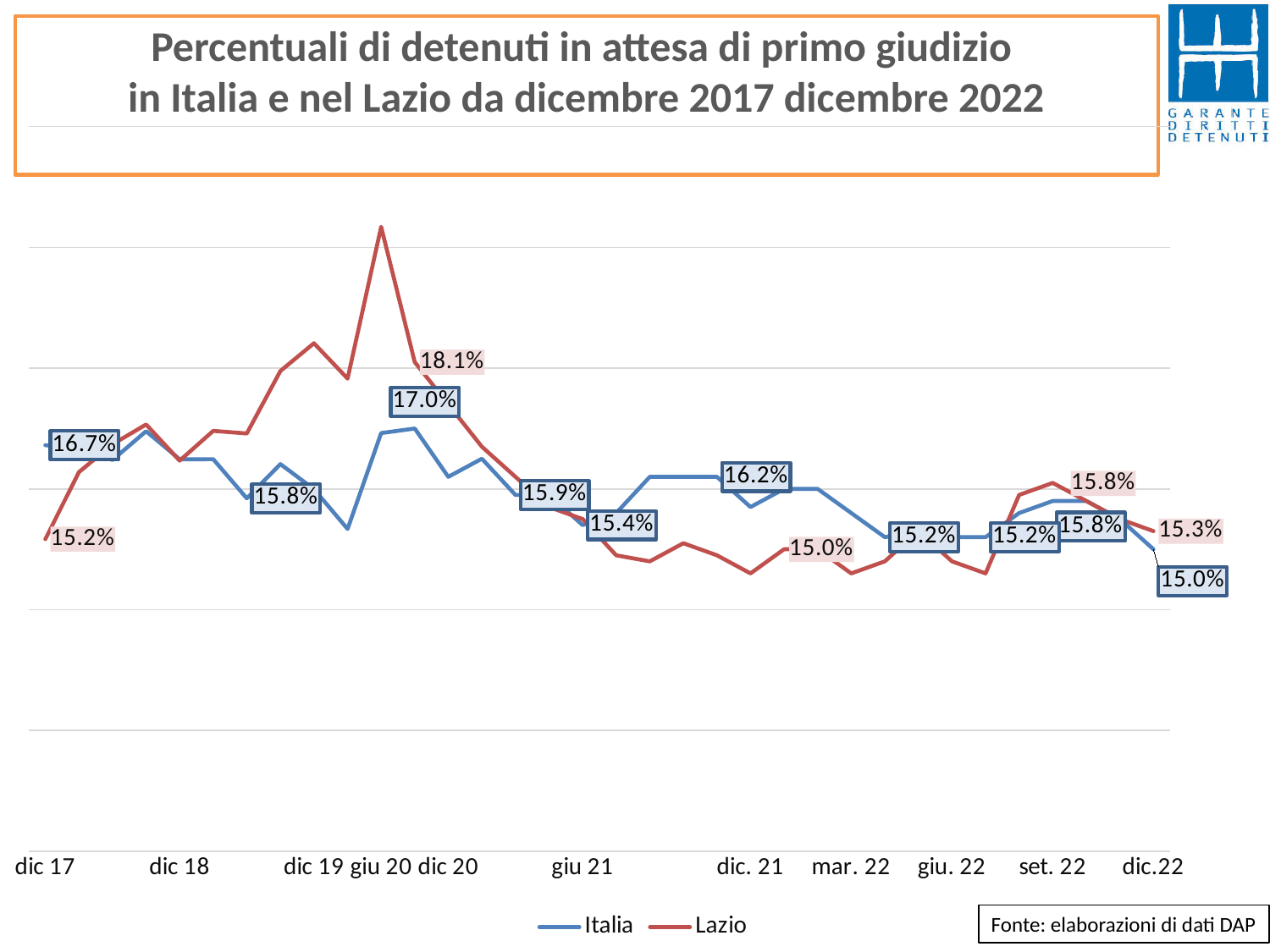
What is the value for Italia at dic.22? 15.0% What kind of chart is shown on the slide? line chart How many series does the legend list? 2 Which series has the higher value at dic.22, Italia or Lazio? Lazio What is the highest labelled value shown for the Lazio series? 18.1% What is the highest labelled value shown for the Italia series? 17.0% What is the difference between the Italia and Lazio values at dic 17? 1.5 percentage points What is the value for Lazio at dic.22? 15.3% Which series has the higher value at dic 17, Italia or Lazio? Italia What is the value for Lazio at dic 17? 15.2% What is the value for Italia at dic 17? 16.7% What source is cited for the data on the slide? Fonte: elaborazioni di dati DAP